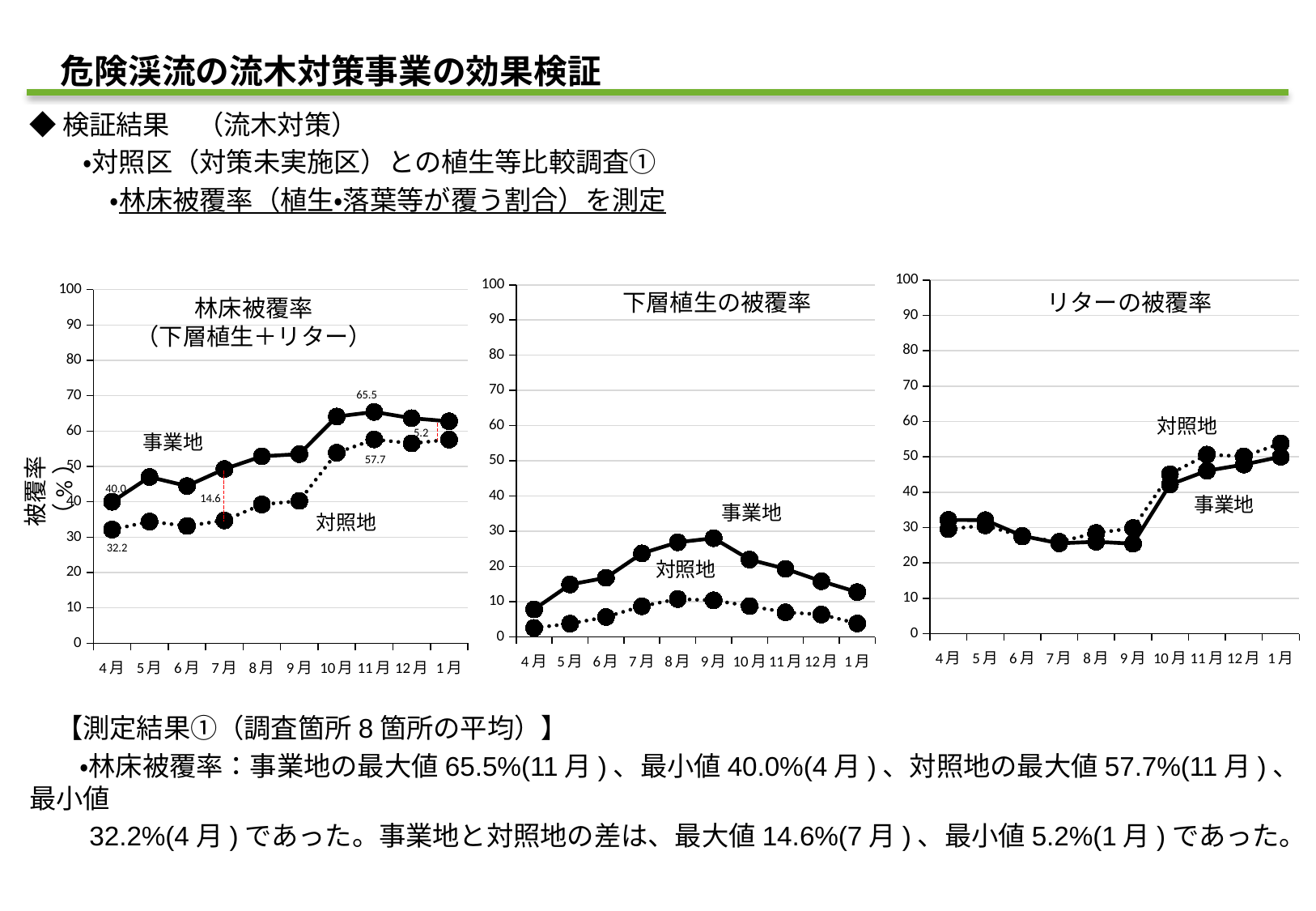
In the リターの被覆率 chart, which series has the higher value in 1月, 事業地 or 対照地? 対照地 In the 林床被覆率（下層植生＋リター） chart, what is the difference between 事業地 and 対照地 in 11月? 7.8 In the 下層植生の被覆率 chart, do the 事業地 values rise or fall from 9月 to 1月? fall In the 林床被覆率（下層植生＋リター） chart, what is the value for 事業地 in 4月? 40.0 In the リターの被覆率 chart, is the value for 事業地 in 1月 greater or less than 40? greater How many series are plotted in the 下層植生の被覆率 chart? 2 In the 下層植生の被覆率 chart, is the value for 事業地 in 9月 greater or less than 20? greater In the 林床被覆率（下層植生＋リター） chart, what is the value for 対照地 in 11月? 57.7 In the 林床被覆率（下層植生＋リター） chart, what is the value for 事業地 in 11月? 65.5 In the 林床被覆率（下層植生＋リター） chart, what is the value for 対照地 in 4月? 32.2 In the 林床被覆率（下層植生＋リター） chart, how many months are shown on the x axis? 10 What kind of chart is the 林床被覆率（下層植生＋リター） chart? line chart